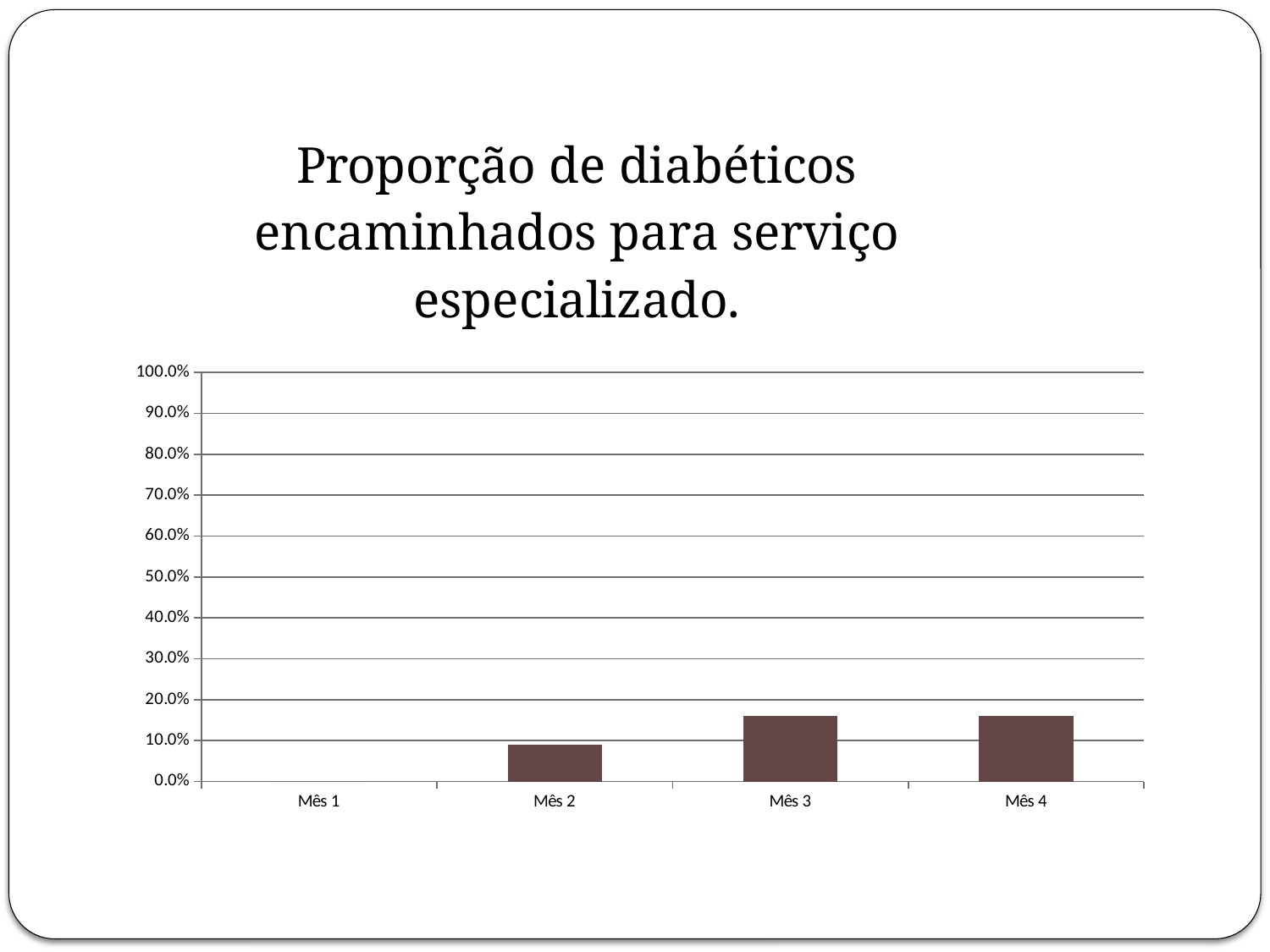
What kind of chart is shown on the slide? bar chart Is the value for Mês 4 greater or less than 20.0%? less Which month has the lowest proportion of diabetics referred to specialized service? Mês 1 What is the title of the chart? Proporção de diabéticos encaminhados para serviço especializado. Is the value for Mês 3 greater or less than 10.0%? greater Is the value for Mês 3 greater or less than 20.0%? less Do the values generally rise or fall from Mês 1 to Mês 4? rise Which is larger, the value for Mês 2 or the value for Mês 3? Mês 3 Which is larger, the value for Mês 1 or the value for Mês 2? Mês 2 What is the highest value shown on the y axis? 100.0% How many months (categories) are shown on the x axis? 4